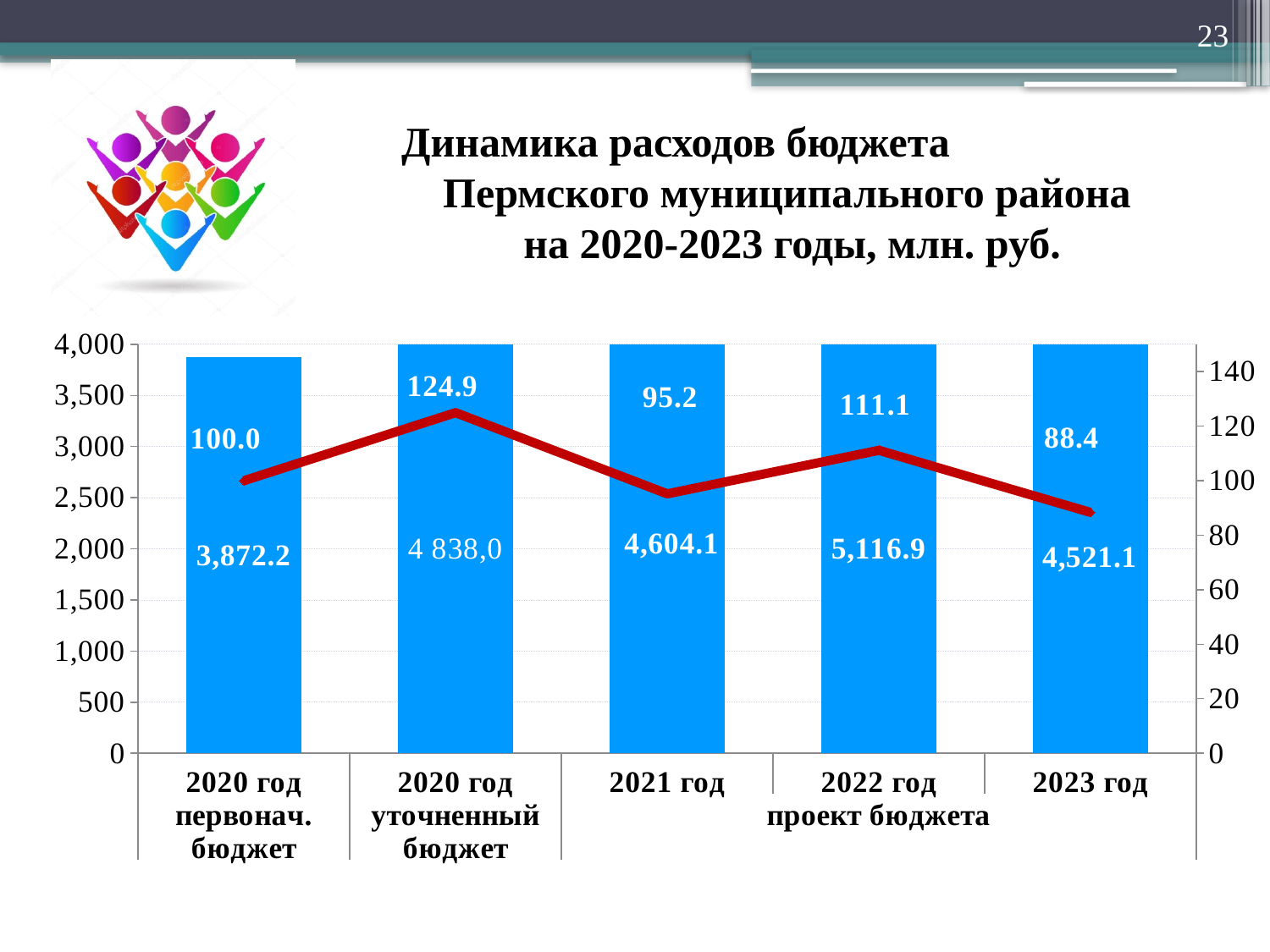
Which category has the lowest bar value? 2020 год первонач. бюджет What is the line value shown for 2023 год? 88.4 What is the bar value for 2022 год? 5,116.9 What is the difference between the bar values for 2022 год and 2023 год? 595.8 What kind of chart is this? Bar chart with a line Which category has the highest bar value? 2022 год Which is larger, the bar value for 2021 год or for 2023 год? 2021 год Which category has the highest line value? 2020 год уточненный бюджет How many categories are shown on the x axis? 5 What is the bar value for 2020 год уточненный бюджет? 4 838,0 What is the line value shown above the 2021 год bar? 95.2 What is the bar value for 2020 год первонач. бюджет? 3,872.2